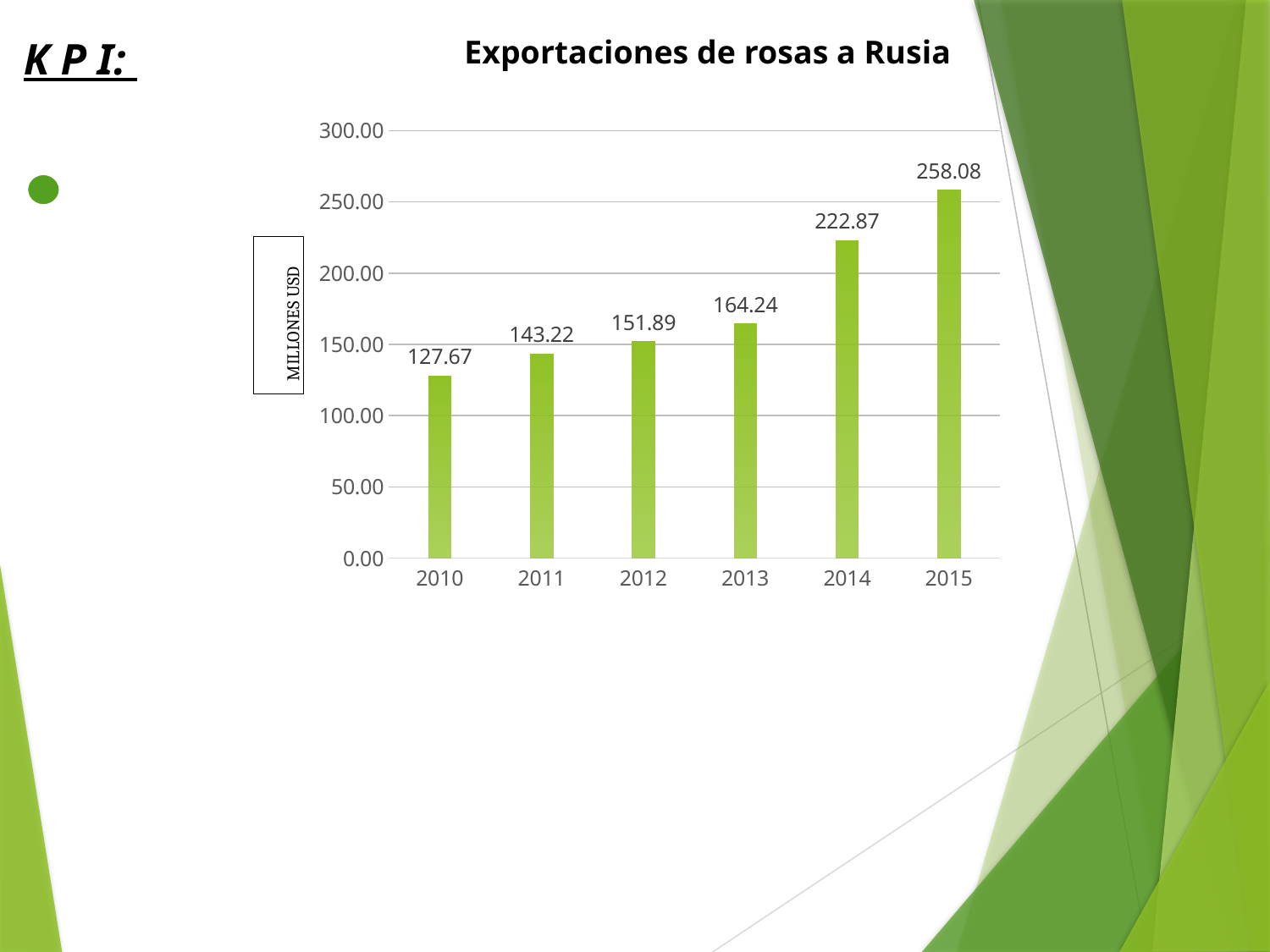
What is the value for 2013? 164.24 What is the difference between the values for 2015 and 2014? 35.21 What kind of chart is this? bar chart Do the values rise or fall from 2010 to 2015? rise What is the value for 2015? 258.08 Which is larger, the value for 2014 or the value for 2013? 2014 Is the value for 2014 greater or less than 200.00? greater What is the difference between the values for 2012 and 2011? 8.67 Which year has the lowest value? 2010 How many years are shown on the x axis? 6 What is the value for 2010? 127.67 Which year has the highest value? 2015